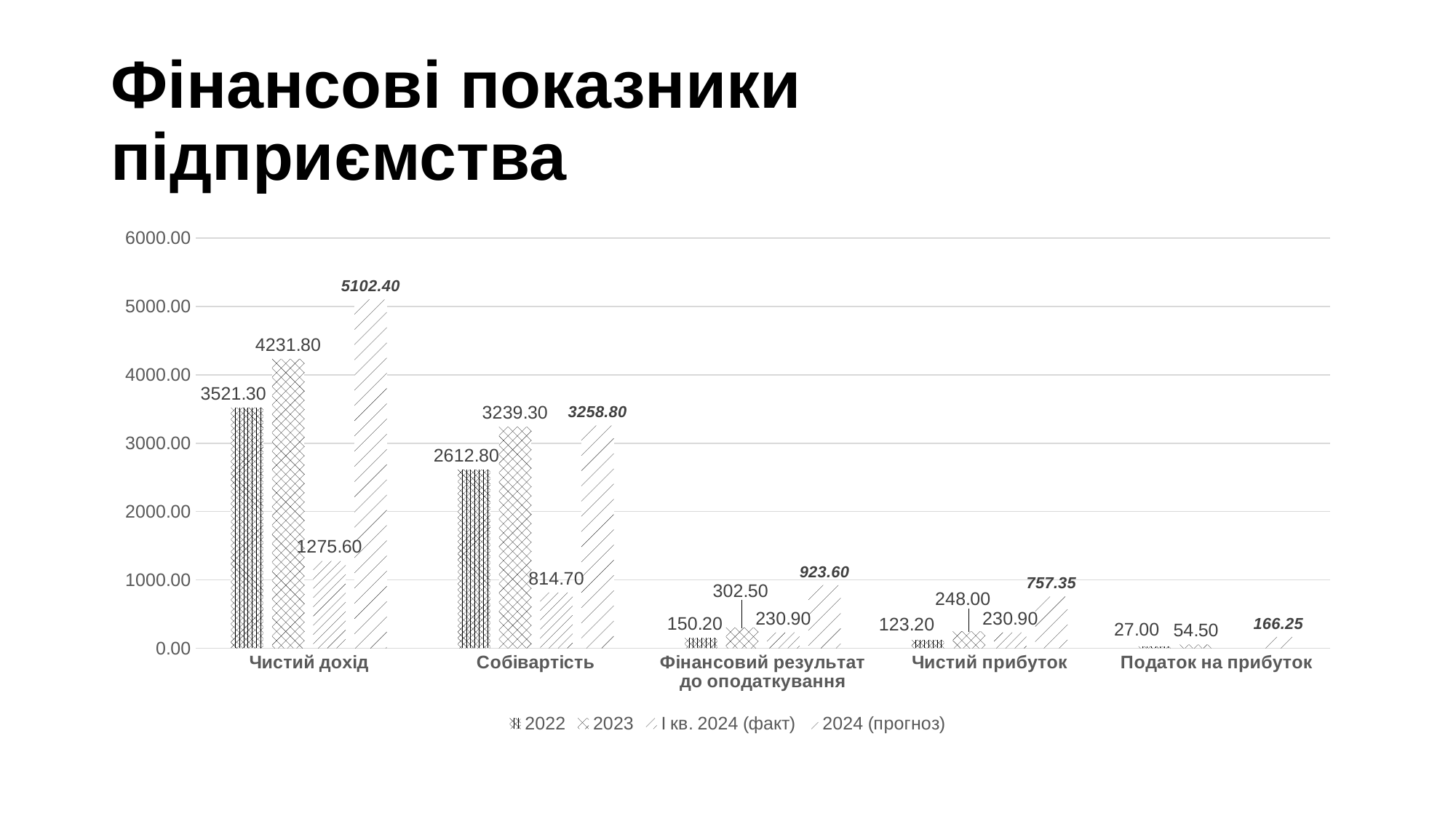
Is the value for Чистий дохід in the I кв. 2024 (факт) series greater or less than 2000.00? less What is the value for Собівартість in the 2024 (прогноз) series? 3258.80 What is the value for Чистий дохід in the 2023 series? 4231.80 Which category has the lowest value in the 2022 series? Податок на прибуток Which category has the highest value in the 2024 (прогноз) series? Чистий дохід How many series does the legend list? 4 What is the difference between the 2024 (прогноз) and 2023 values for Чистий дохід? 870.60 Which is larger for Собівартість: the 2023 value or the 2024 (прогноз) value? 2024 (прогноз) What is the value for Чистий прибуток in the 2022 series? 123.20 How many categories are shown on the x axis? 5 What kind of chart is shown on the slide? bar chart What is the value for Податок на прибуток in the 2024 (прогноз) series? 166.25